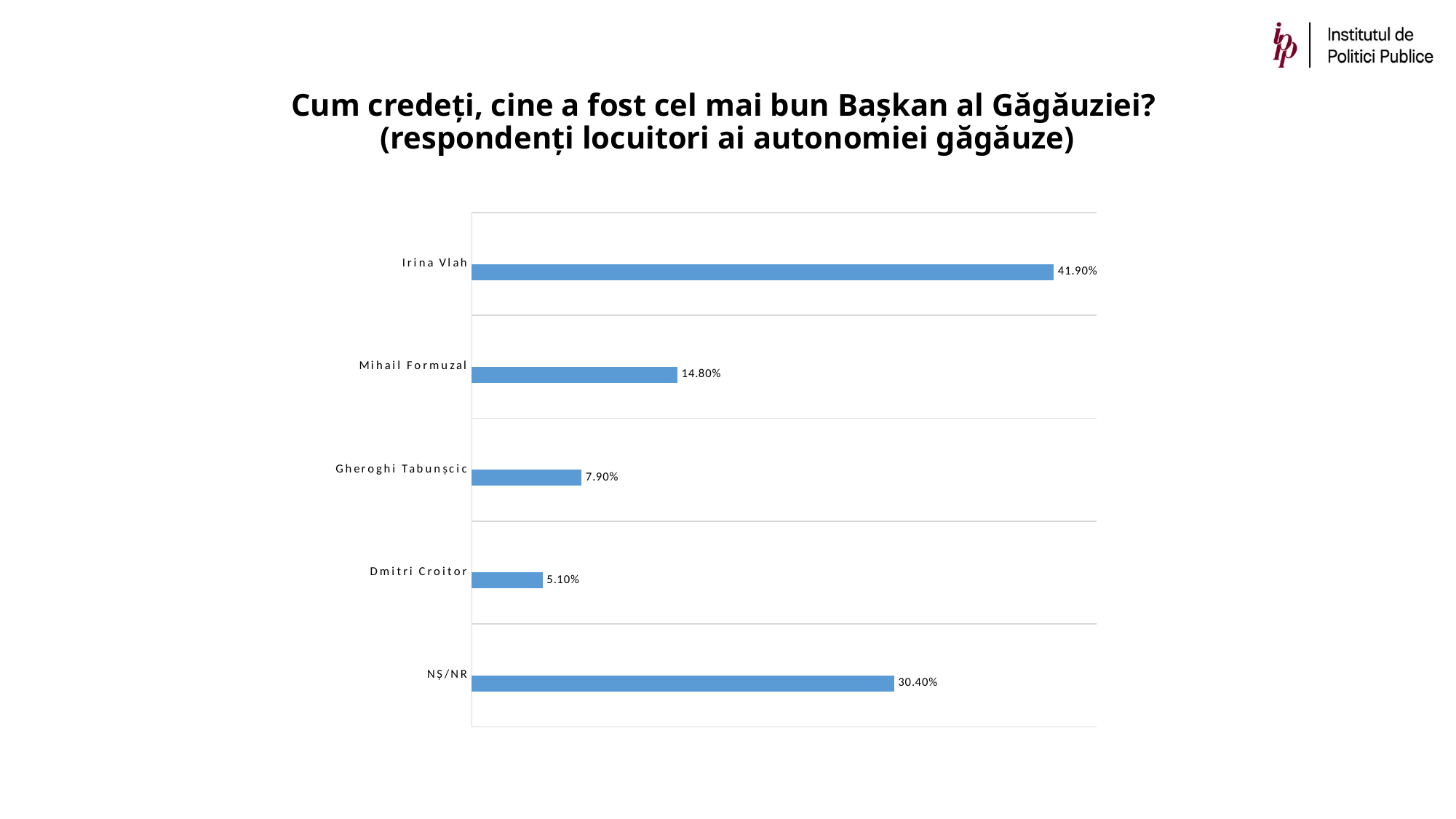
Which is larger, the value for Mihail Formuzal or the value for NȘ/NR? NȘ/NR What is the value shown for Gheroghi Tabunșcic? 7.90% What is the difference between the values for Mihail Formuzal and Gheroghi Tabunșcic? 6.90% What is the difference between the values for Irina Vlah and NȘ/NR? 11.50% Which category has the lowest value on the chart? Dmitri Croitor What is the value shown for Dmitri Croitor? 5.10% What percentage of respondents answered NȘ/NR? 30.40% What kind of chart is shown on the slide? Bar chart What percentage of respondents named Irina Vlah as the best Bashkan of Gagauzia? 41.90% How many categories are shown on the chart? 5 Which category has the highest value on the chart? Irina Vlah What is the value shown for Mihail Formuzal? 14.80%